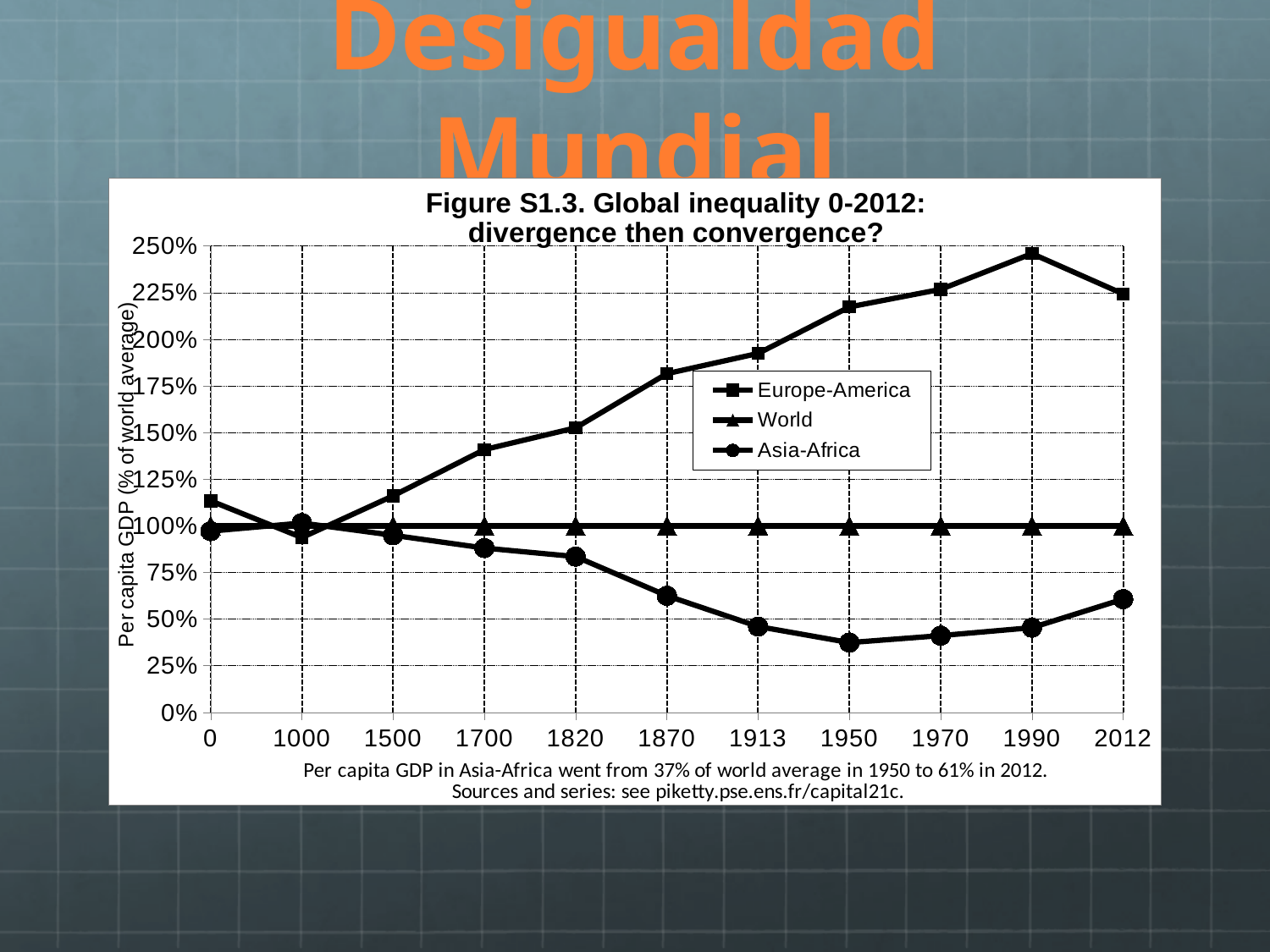
What was per capita GDP in Asia-Africa as a percentage of the world average in 1950? 37% How many years are marked along the x axis? 11 In which year does the Asia-Africa series reach its lowest value? 1950 What kind of chart is shown on the slide? line chart What value does the World series hold across all years? 100% In 2012, which series is higher: Europe-America or Asia-Africa? Europe-America How many series does the legend list? 3 Is the value for Europe-America in 1990 greater or less than 225%? greater In which year does the Europe-America series reach its highest value? 1990 What was per capita GDP in Asia-Africa as a percentage of the world average in 2012? 61% Is the value for Asia-Africa in 1870 greater or less than 75%? less By how many percentage points did Asia-Africa's per capita GDP (as % of world average) rise between 1950 and 2012? 24 percentage points